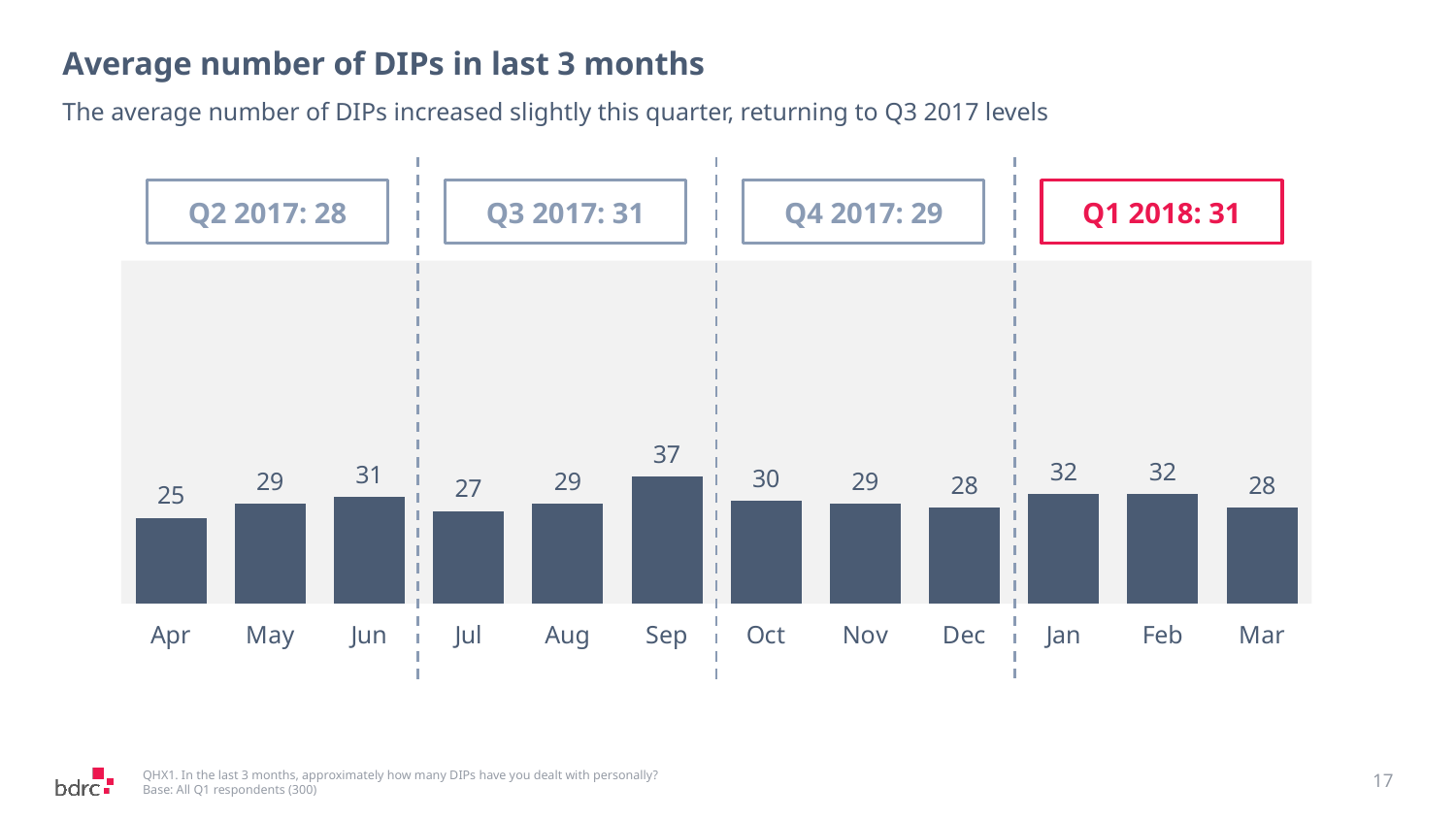
What is the average number of DIPs for Apr? 25 How many months are plotted on the chart? 12 What is the difference between the values for Feb and Mar? 4 What kind of chart is shown on the slide? Bar chart What is the average number of DIPs for Sep? 37 What is the value shown for Jan? 32 Which month has the lowest average number of DIPs? Apr What is the difference between the values for Sep and Apr? 12 What is the title of the chart? Average number of DIPs in last 3 months Which is larger, the value for Jun or the value for Jul? Jun What is the quarterly average shown for Q1 2018? 31 Which month has the highest average number of DIPs? Sep